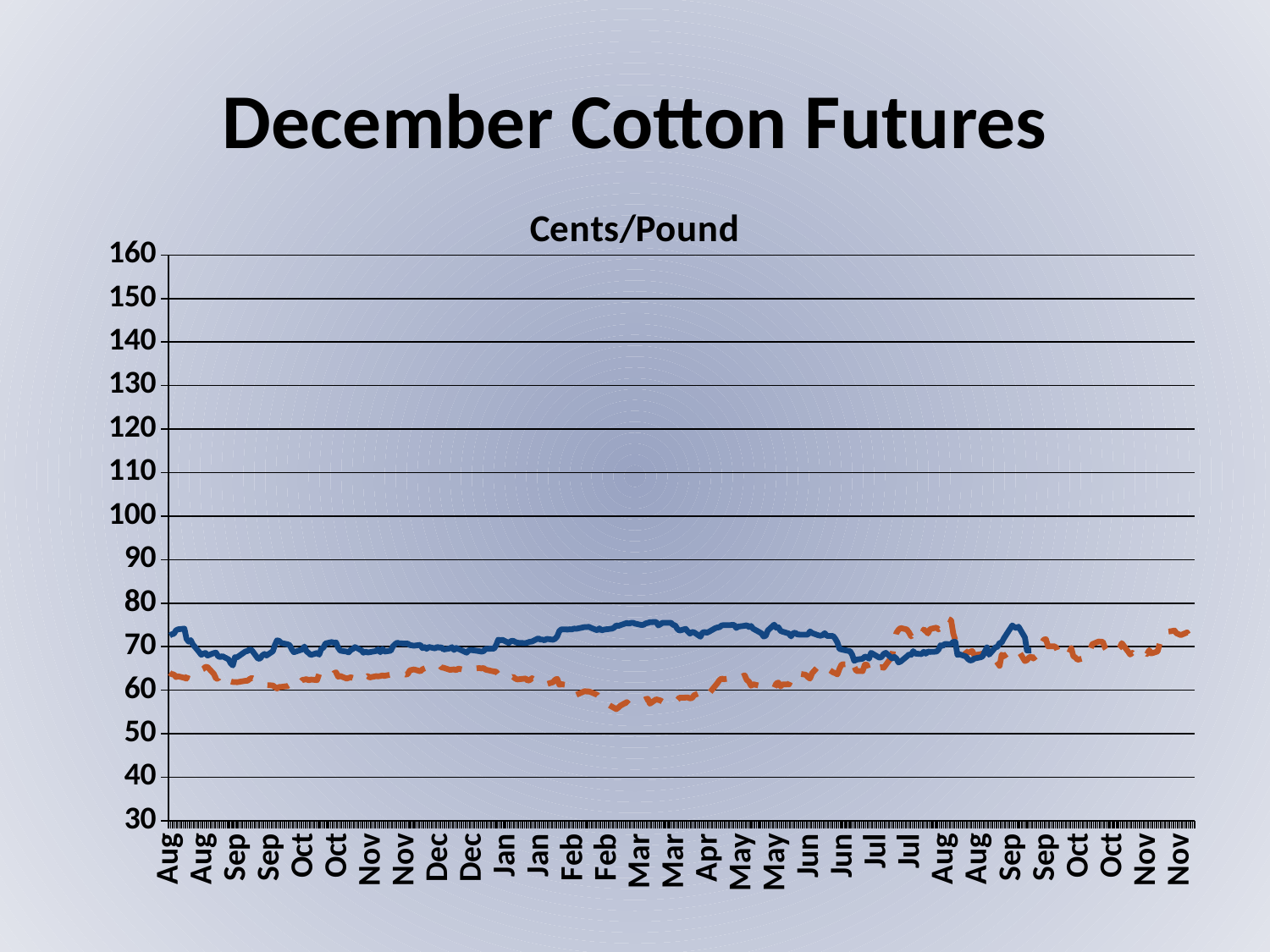
Is the value of the dashed orange line at Mar greater or less than 60? less At Feb, which line is higher, the solid blue line or the dashed orange line? the solid blue line What kind of chart is shown on the slide? line chart Is the value of the solid blue line at Mar greater or less than 70? greater Is the value of the dashed orange line at the final Nov greater or less than 70? greater Does the dashed orange line rise or fall from Feb to the final Nov? rise What is the highest value shown on the vertical axis? 160 What is the title printed above the chart's plot area? Cents/Pound How many lines are plotted on the chart? 2 At Mar, which line is lower, the solid blue line or the dashed orange line? the dashed orange line